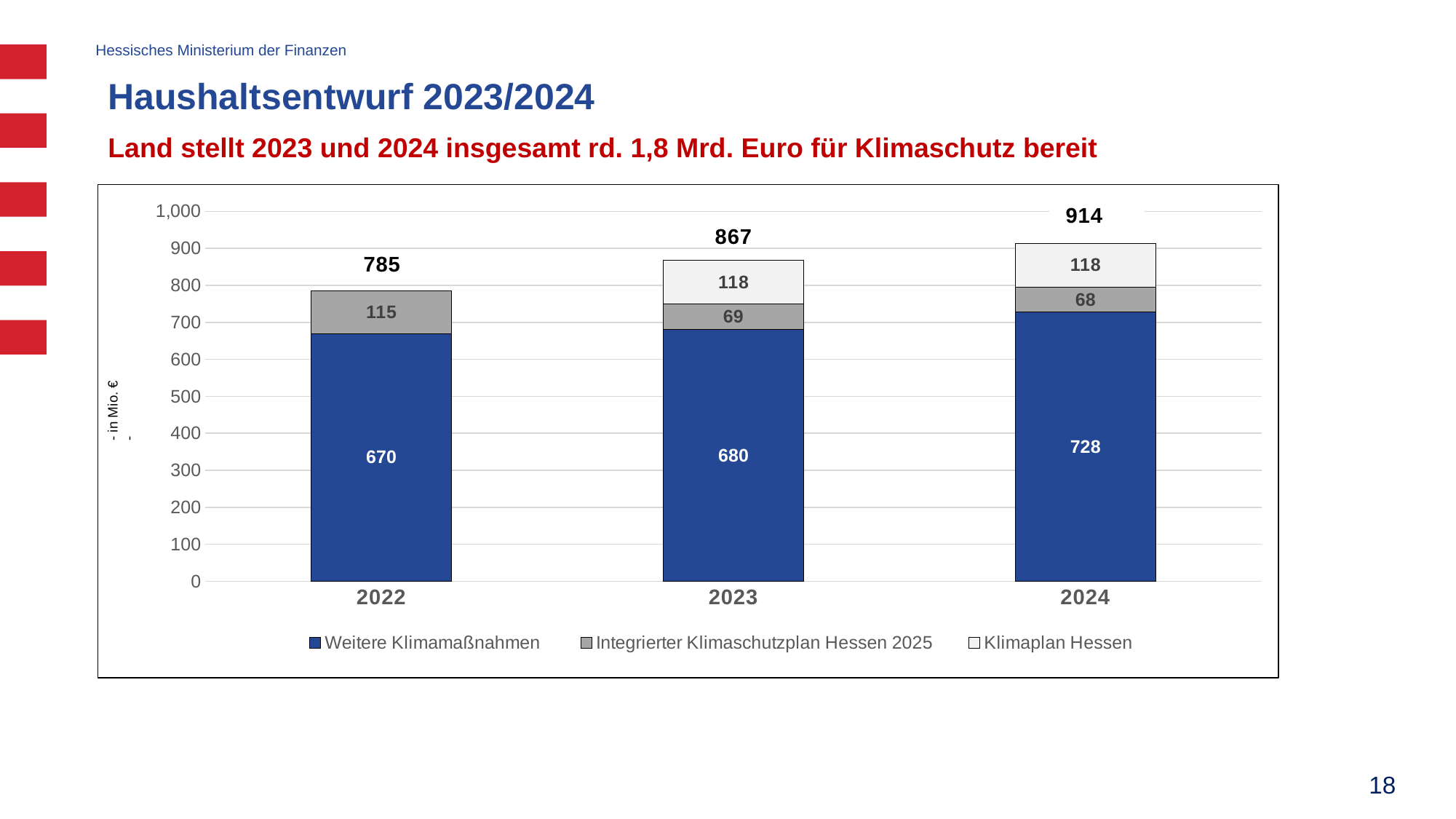
What is the total of the stacked bar for 2023? 867 Do the totals rise or fall from 2022 to 2024? Rise Which year has the lowest total? 2022 What is the value for Klimaplan Hessen in 2023? 118 What kind of chart is shown? Stacked bar chart What is the value for Integrierter Klimaschutzplan Hessen 2025 in 2022? 115 Which year has the highest total? 2024 What is the value for Weitere Klimamaßnahmen in 2024? 728 What is the difference between the totals for 2024 and 2022? 129 Which is larger, Weitere Klimamaßnahmen in 2023 or in 2022? 2023 How many years are shown on the x axis? 3 How many series does the legend list? 3